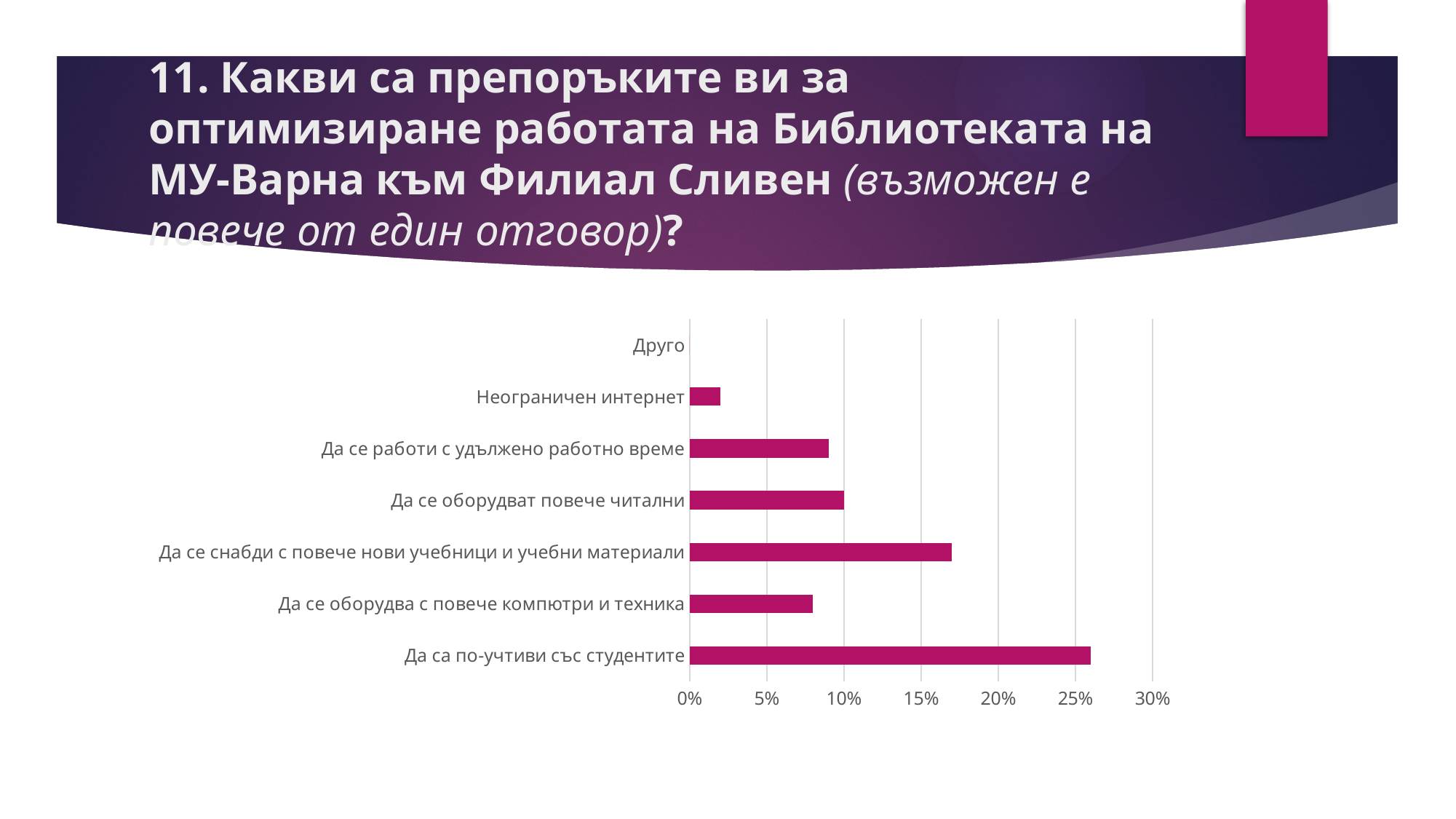
Is the value for "Да са по-учтиви със студентите" greater or less than 25%? greater Which category has the lowest value in the chart? Друго Is the value for "Да се оборудва с повече компютри и техника" greater or less than 10%? less Which is larger: the value for "Да се снабди с повече нови учебници и учебни материали" or for "Да се оборудва с повече компютри и техника"? Да се снабди с повече нови учебници и учебни материали Is the value for "Неограничен интернет" greater or less than 5%? less What kind of chart is shown on the slide? bar chart Which is larger: the value for "Да са по-учтиви със студентите" or for "Да се оборудват повече читални"? Да са по-учтиви със студентите How many categories are plotted in the chart? 7 What colour are the bars in the chart? magenta Which category has the highest value in the chart? Да са по-учтиви със студентите